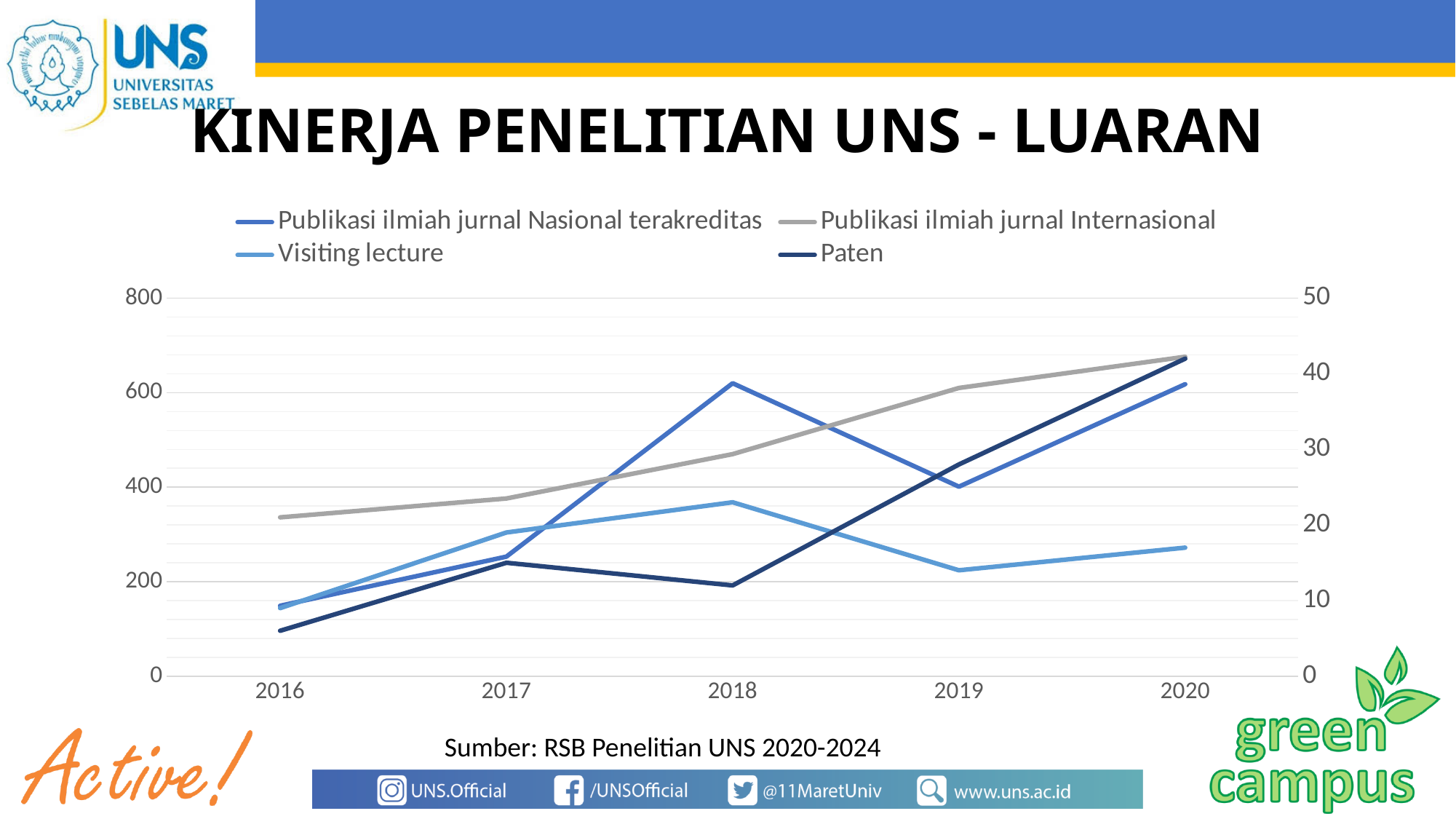
In which year does the Visiting lecture line peak? 2018 Does the Publikasi ilmiah jurnal Internasional line rise or fall from 2016 to 2020? rise In which year is the Publikasi ilmiah jurnal Nasional terakreditas line at its lowest? 2016 How many years are shown on the x axis? 5 For Publikasi ilmiah jurnal Nasional terakreditas, is the value in 2018 or 2019 larger? 2018 What is the title of the slide containing the chart? KINERJA PENELITIAN UNS - LUARAN How many series does the legend list? 4 Which series is drawn in grey in the legend? Publikasi ilmiah jurnal Internasional In which year is the Paten line at its lowest? 2016 In which year is the Paten line at its highest? 2020 What kind of chart is shown on the slide? line chart